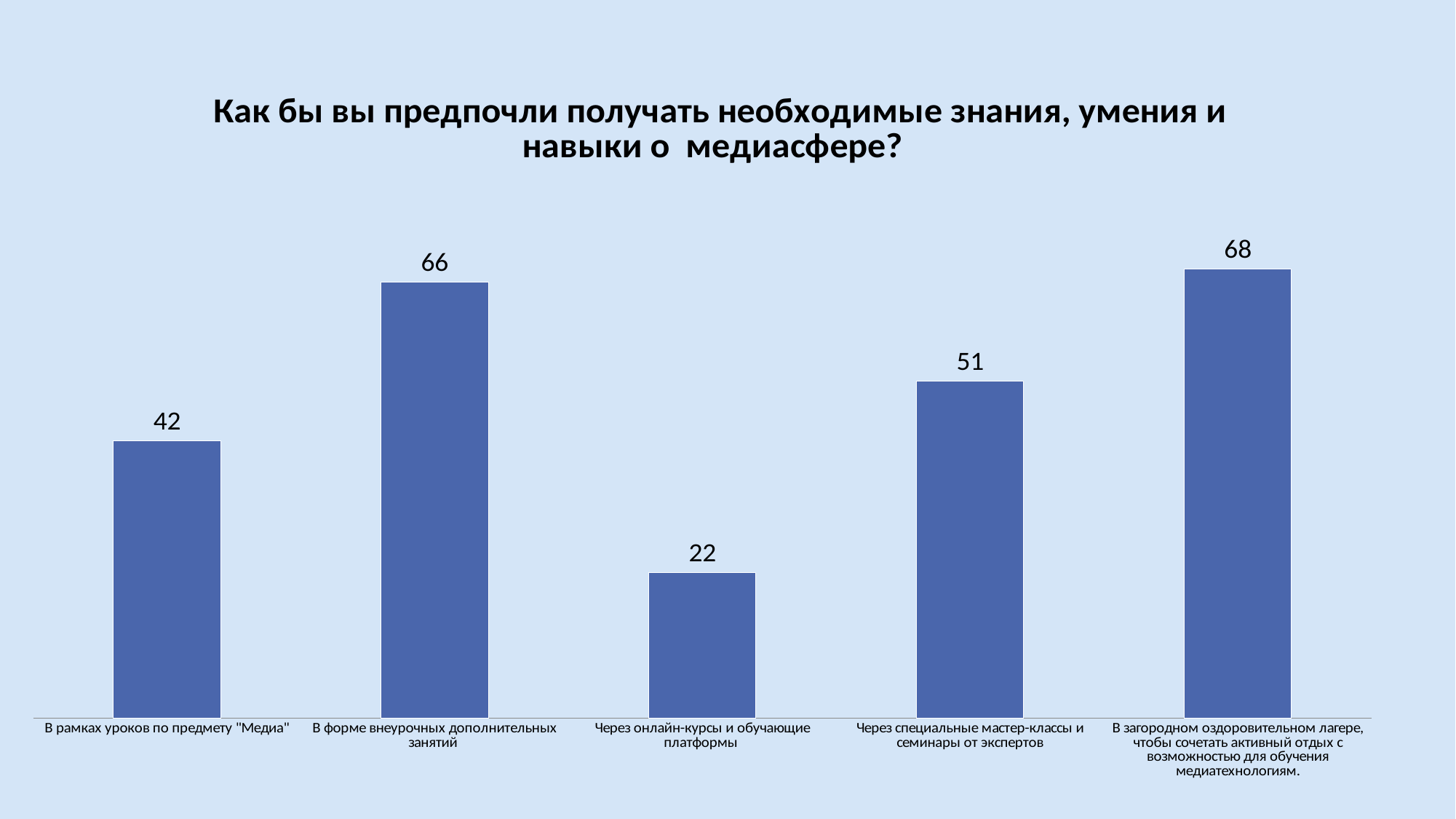
What is the value for "В рамках уроков по предмету "Медиа""? 42 What is the title of the chart? Как бы вы предпочли получать необходимые знания, умения и навыки о медиасфере? Which category has the highest value? В загородном оздоровительном лагере, чтобы сочетать активный отдых с возможностью для обучения медиатехнологиям. What is the difference between the values for "В форме внеурочных дополнительных занятий" and "В рамках уроков по предмету "Медиа""? 24 Which category has the lowest value? Через онлайн-курсы и обучающие платформы What is the value for "Через специальные мастер-классы и семинары от экспертов"? 51 What kind of chart is shown on the slide? Bar chart What is the difference between the highest and lowest values on the chart? 46 What is the value for "Через онлайн-курсы и обучающие платформы"? 22 Which is larger: the value for "Через специальные мастер-классы и семинары от экспертов" or the value for "В рамках уроков по предмету "Медиа""? Через специальные мастер-классы и семинары от экспертов What is the value for "В форме внеурочных дополнительных занятий"? 66 How many categories are shown on the chart? 5